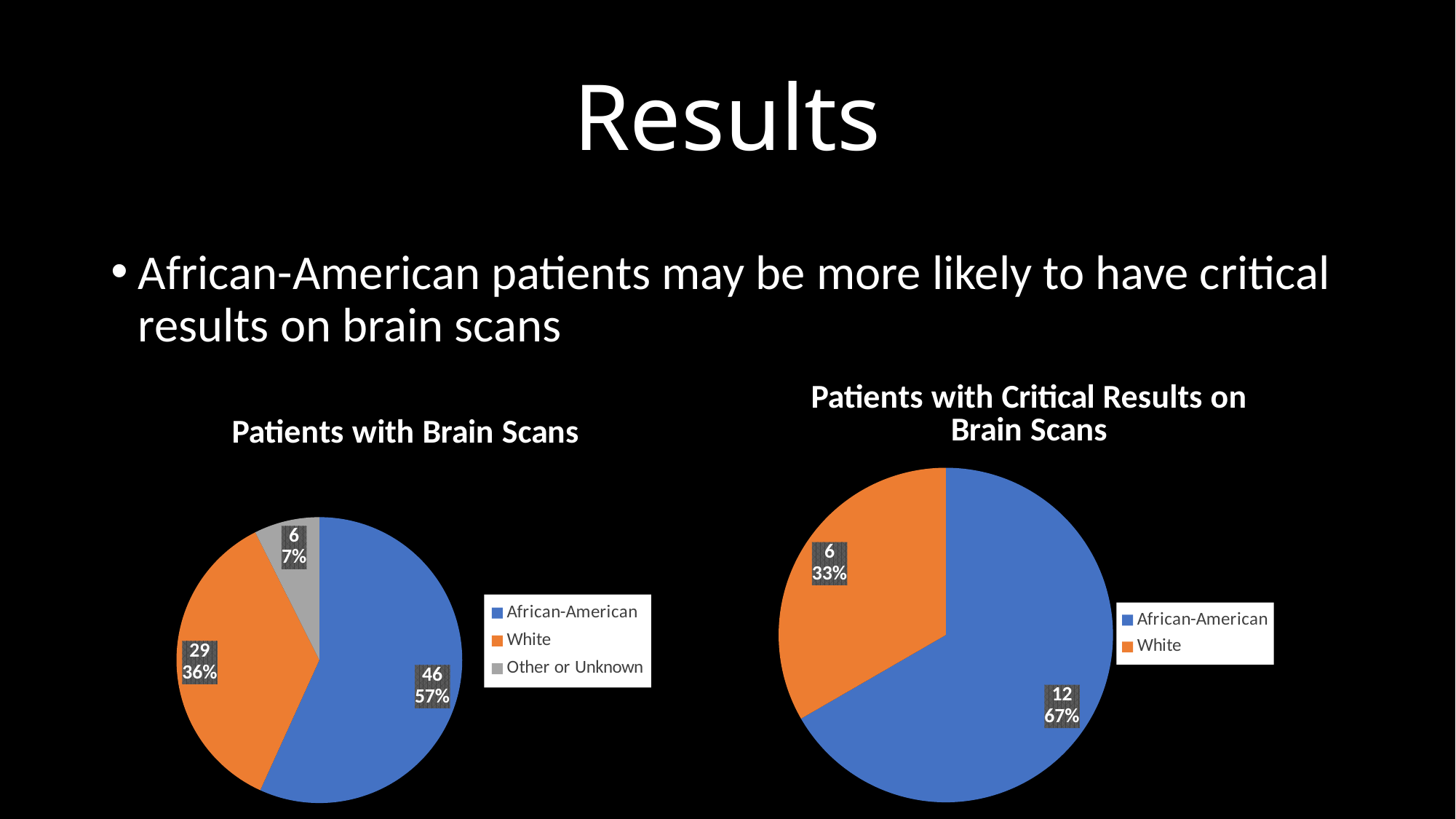
In the 'Patients with Brain Scans' chart, which category has the largest slice? African-American In the 'Patients with Critical Results on Brain Scans' chart, what share of the pie is White? 33% In the 'Patients with Critical Results on Brain Scans' chart, how many patients are African-American? 12 In the 'Patients with Critical Results on Brain Scans' chart, how many entries does the legend list? 2 In the 'Patients with Brain Scans' chart, how many patients are Other or Unknown? 6 In the 'Patients with Brain Scans' chart, how many categories are shown? 3 In the 'Patients with Brain Scans' chart, what is the difference between the African-American and White counts? 17 In the 'Patients with Brain Scans' chart, what share of the pie is White? 36% In the 'Patients with Brain Scans' chart, which category has the smallest slice? Other or Unknown In the 'Patients with Critical Results on Brain Scans' chart, which is larger, African-American or White? African-American What type of chart is the 'Patients with Critical Results on Brain Scans' chart? Pie chart In the 'Patients with Brain Scans' chart, how many patients are African-American? 46